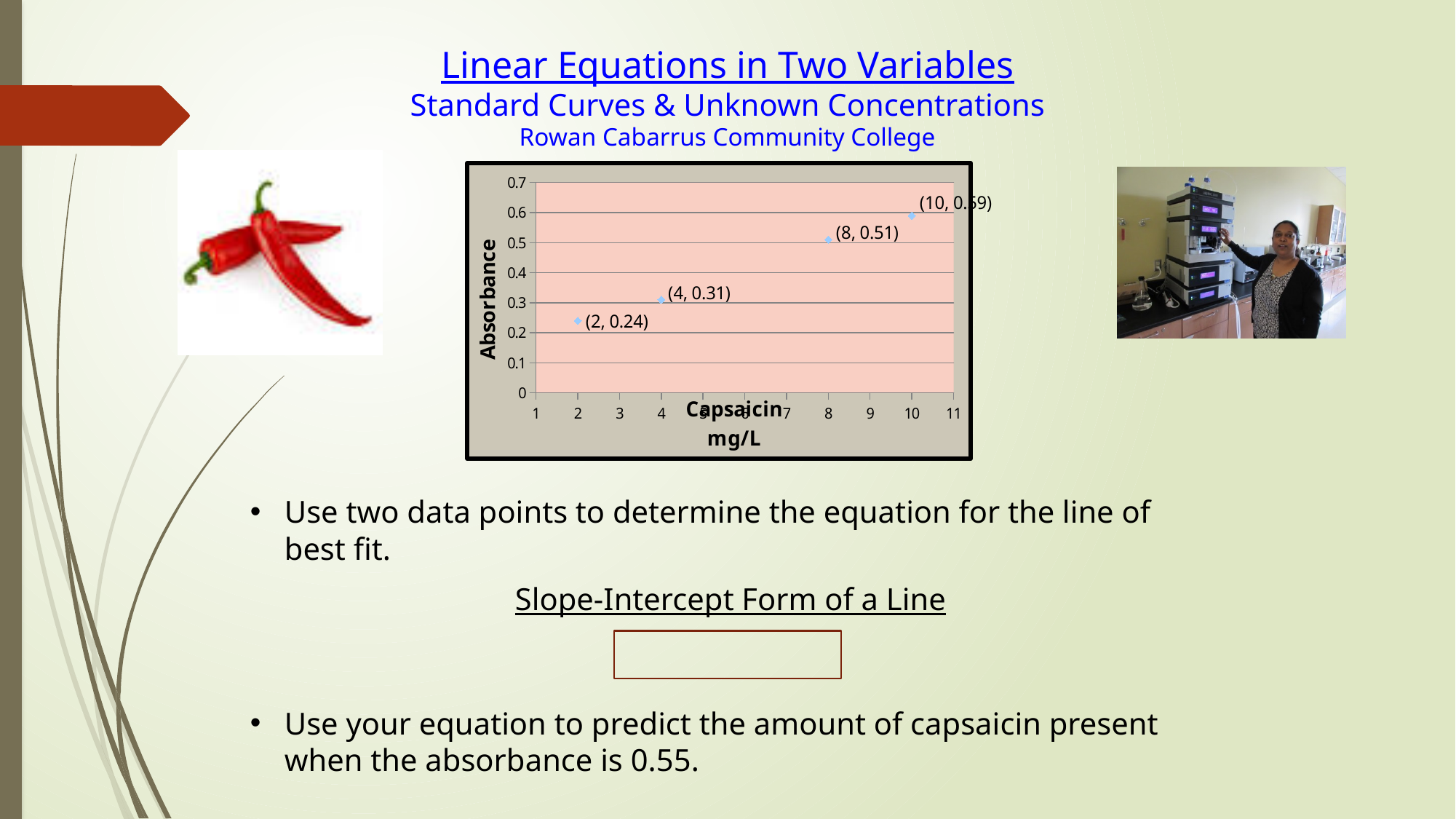
Which capsaicin concentration has the highest absorbance? 10 Which capsaicin concentration has the lowest absorbance? 2 What kind of chart is shown on the slide? scatter chart Which has a larger absorbance, the point at 4 mg/L or the point at 8 mg/L? 8 mg/L Does absorbance rise or fall as capsaicin concentration increases? rise What is the absorbance value at a capsaicin concentration of 8 mg/L? 0.51 What is the absorbance value at a capsaicin concentration of 2 mg/L? 0.24 Is the absorbance at 10 mg/L greater or less than 0.5? greater What is the difference in absorbance between the points at 10 mg/L and 2 mg/L? 0.35 How many data points are plotted on the chart? 4 What is the absorbance value at a capsaicin concentration of 10 mg/L? 0.59 What is the difference in absorbance between the points at 8 mg/L and 4 mg/L? 0.2